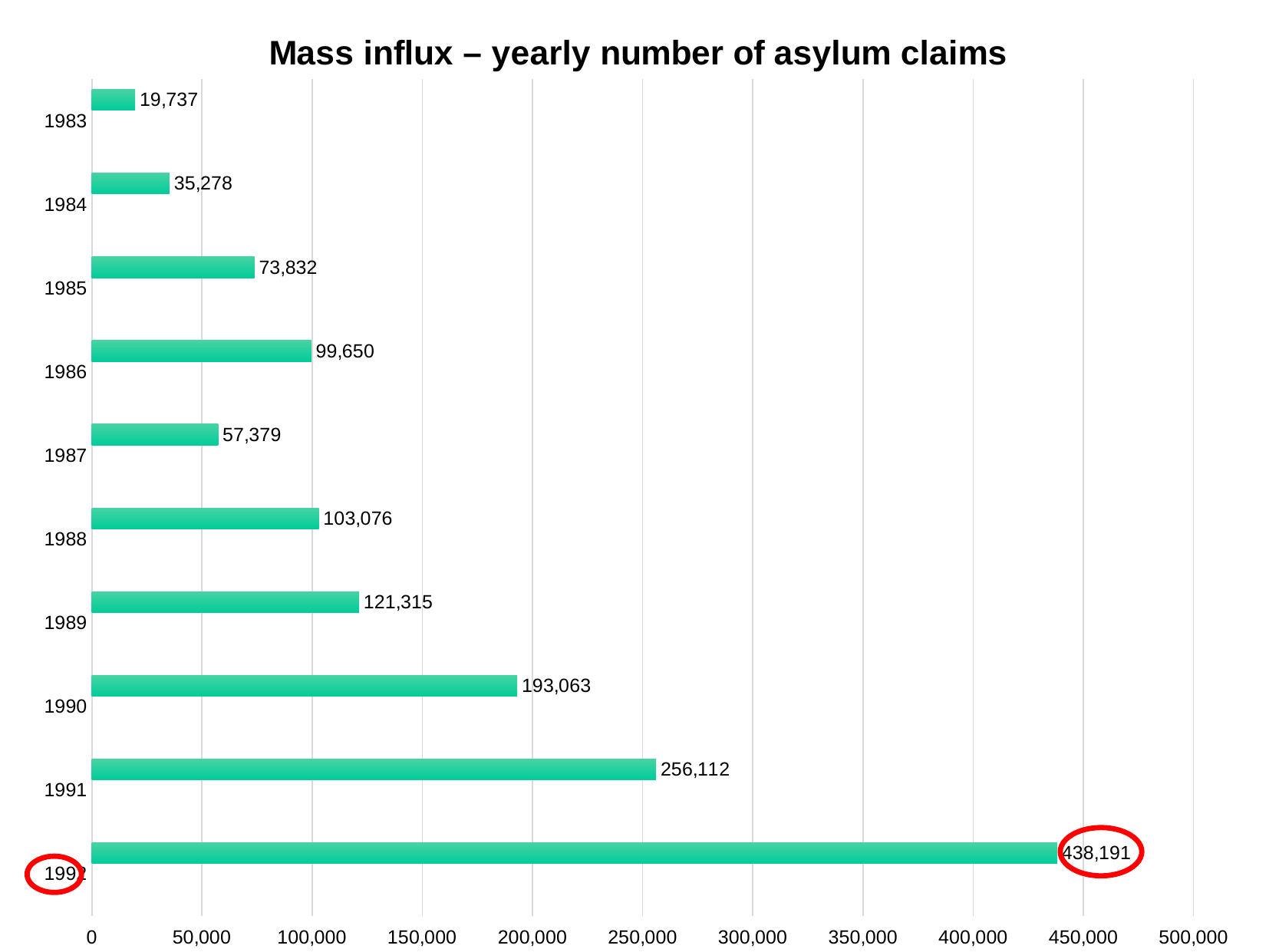
Which year has the lowest number of asylum claims? 1983 Which year has the highest number of asylum claims? 1992 What is the number of asylum claims for 1991? 256,112 What is the number of asylum claims for 1983? 19,737 What is the number of asylum claims for 1986? 99,650 Which value on the chart is circled in red? 438,191 Is the value for 1990 greater or less than 200,000? less How many years are shown in the chart? 10 What is the title of the chart? Mass influx – yearly number of asylum claims What kind of chart is shown on the slide? Bar chart Which year had more asylum claims, 1986 or 1987? 1986 What is the difference in asylum claims between 1992 and 1991? 182,079